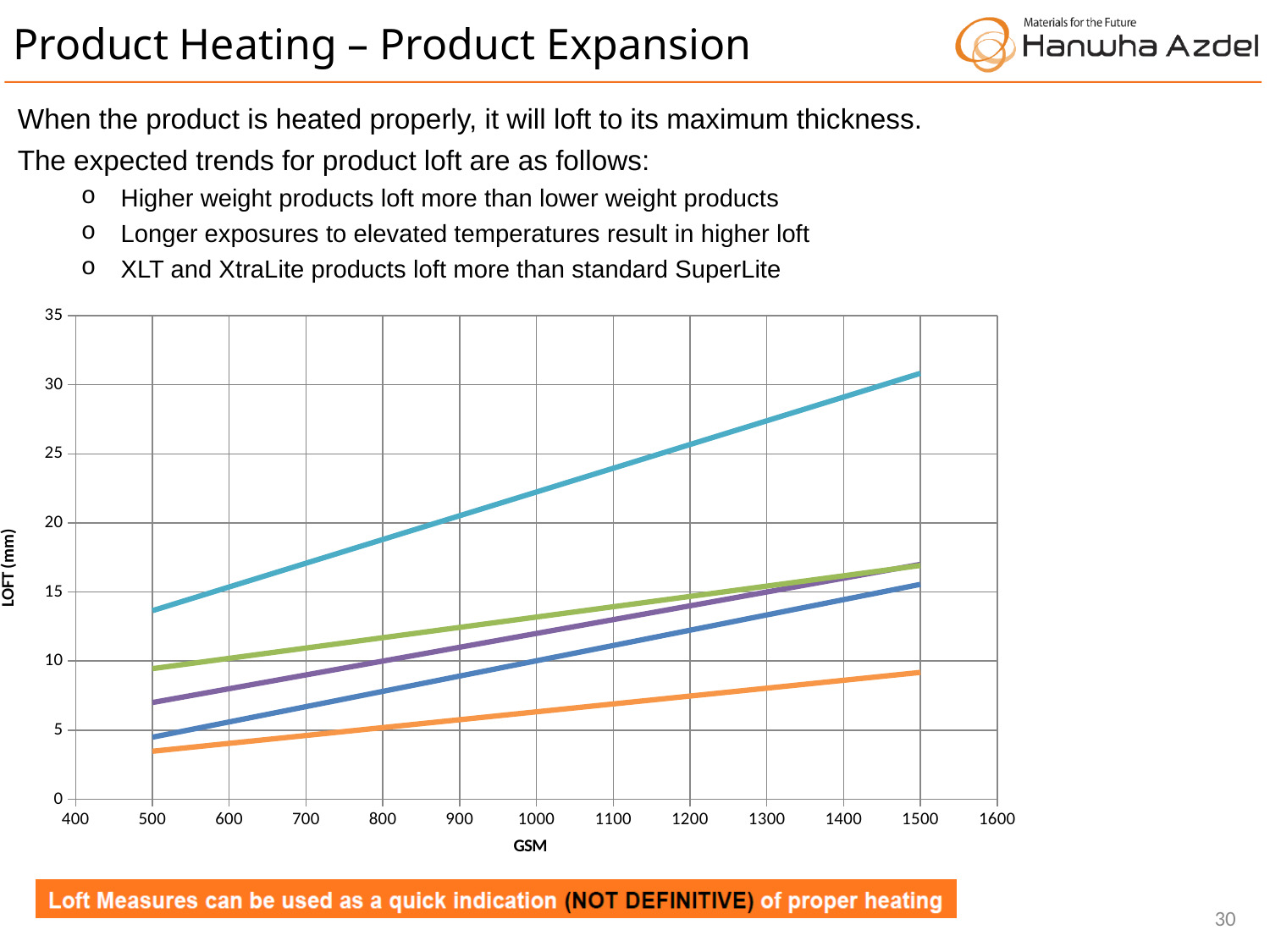
What is the label of the horizontal axis? GSM At 1000 GSM, which line has the larger value: the orange line or the dark blue line? the dark blue line Is the value of the purple line at 500 GSM greater or less than 5? greater Is the value of the light blue (cyan) line at 500 GSM greater or less than 10? greater Which coloured line has the lowest loft values across the chart? the orange line What is the label of the vertical axis? LOFT (mm) What kind of chart is shown on the slide? line chart Do the plotted loft values rise or fall as GSM increases? rise How many lines are plotted on the chart? 5 Is the value of the orange line at 1500 GSM greater or less than 10? less Which coloured line has the highest loft values across the chart? the light blue (cyan) line